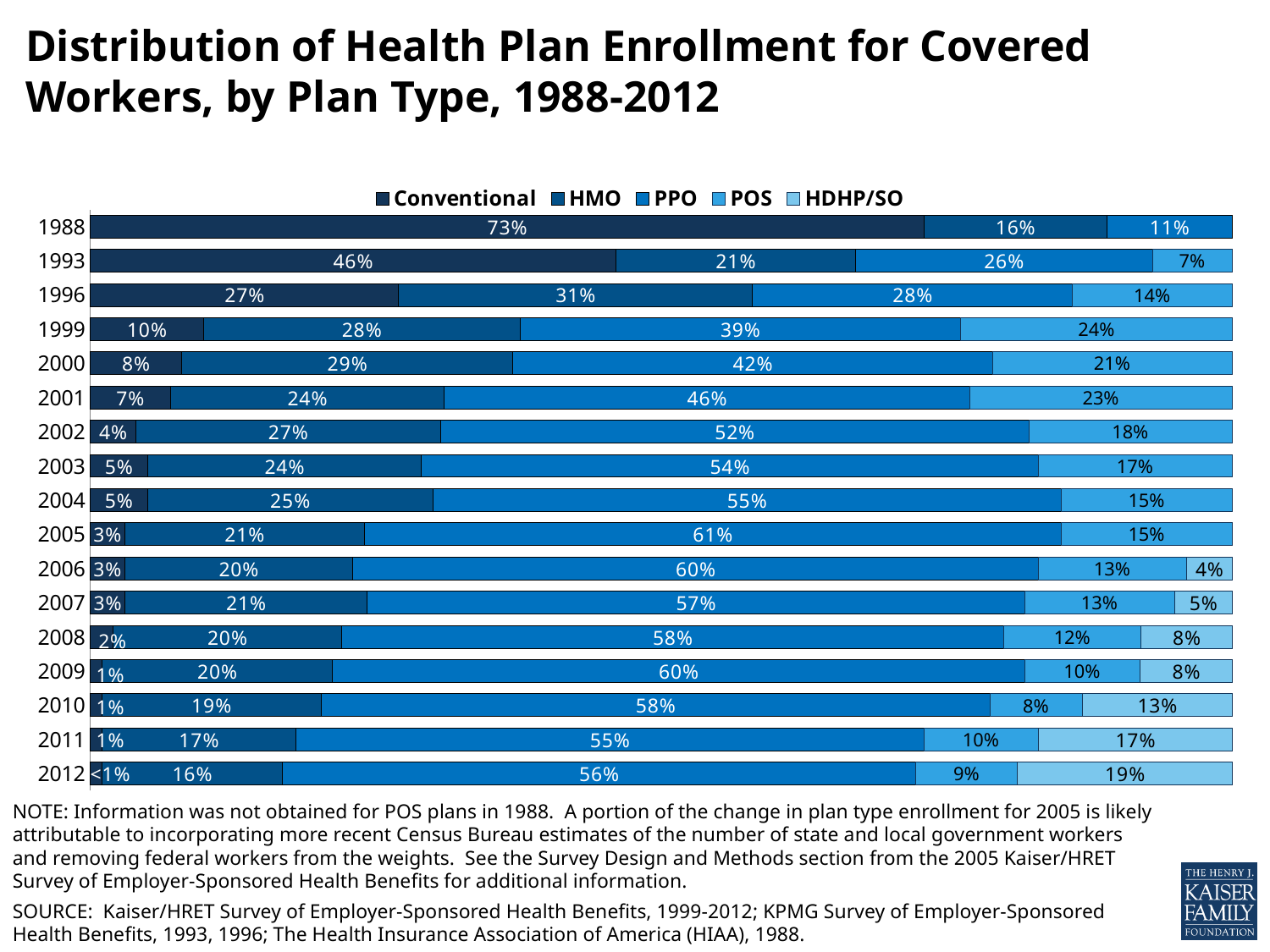
What is the difference between the PPO share in 1999 and the PPO share in 2000? 3 percentage points How many series does the legend list? 5 How does the Conventional plan share change from 1988 to 2012? It falls What kind of chart is shown on the slide? Stacked bar chart What is the difference between the HMO share in 1996 and the HMO share in 2012? 15 percentage points What percentage of covered workers were enrolled in Conventional plans in 1988? 73% What was the HDHP/SO enrollment share in 2006? 4% Which plan type is listed last in the legend? HDHP/SO In which year was the PPO share highest? 2005 What was the PPO enrollment share in 2012? 56% How many years are shown on the chart? 17 Which was larger in 2011, the POS share or the HDHP/SO share? HDHP/SO